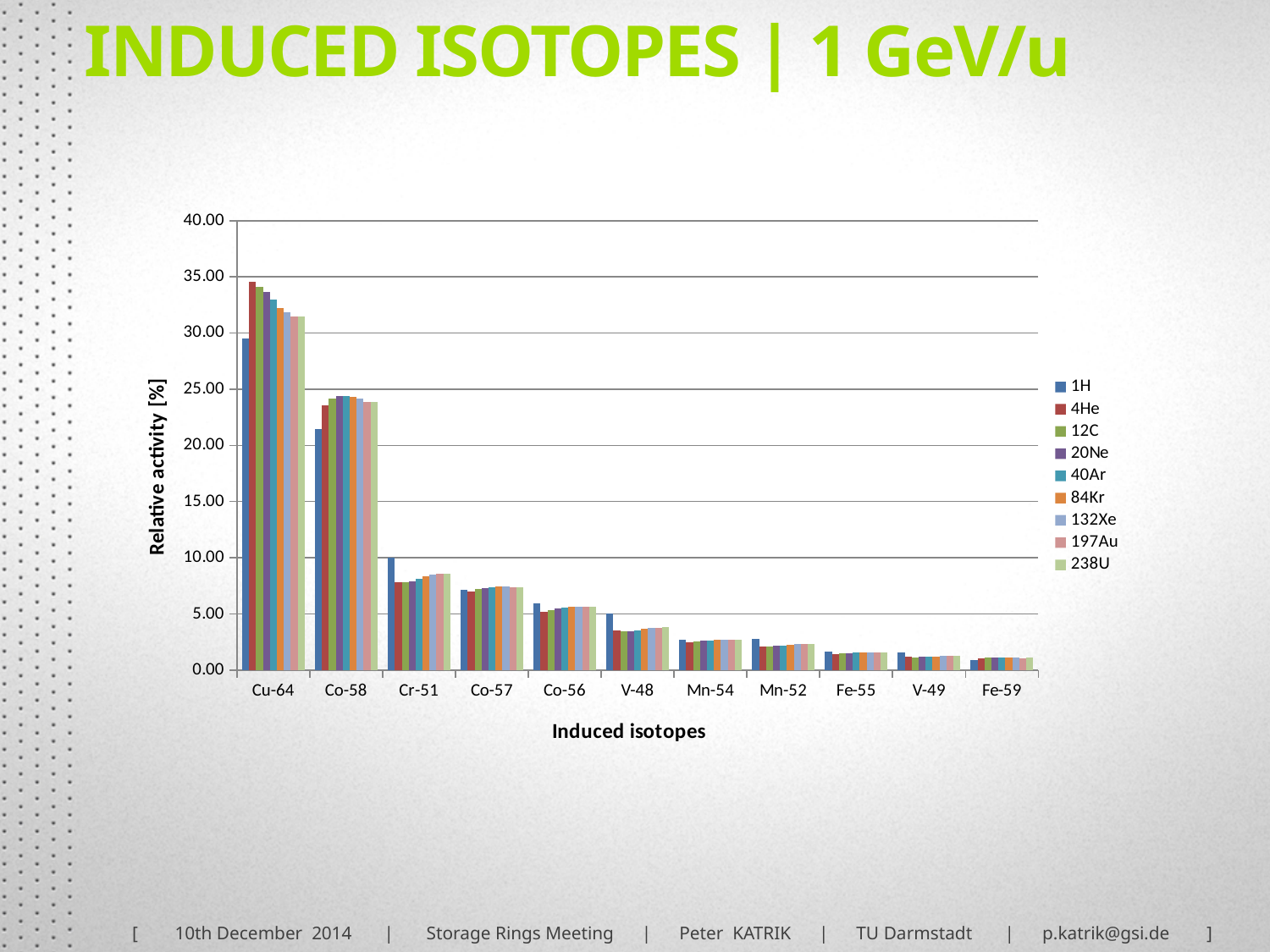
Is the relative activity of Cu-64 for the 1H series greater or less than 25.00? greater How many induced isotopes (categories) are shown on the x axis? 11 Is the relative activity of Cu-64 for the 238U series greater or less than 30.00? greater Do the relative activity values generally rise or fall from left to right along the x axis? fall Which induced isotope has the lowest relative activity? Fe-59 Is the relative activity of Mn-54 for the 1H series greater or less than 5.00? less How many series does the legend list? 9 What kind of chart is shown on the slide? bar chart For the 1H series, which has the larger relative activity, Cu-64 or Co-58? Cu-64 Which induced isotope has the highest relative activity? Cu-64 What is the label of the y axis? Relative activity [%]